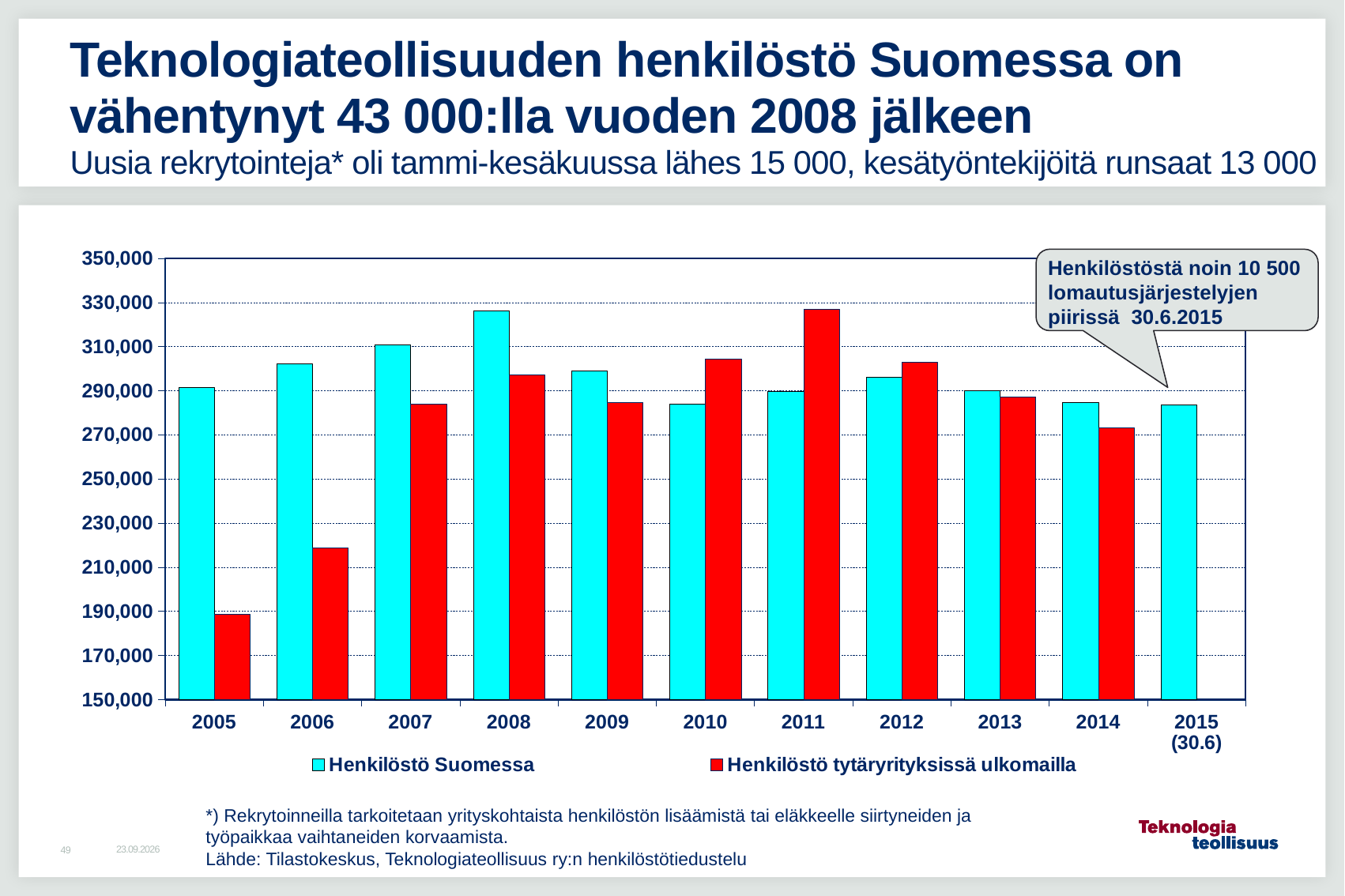
Is the value for Henkilöstö Suomessa in 2008 greater or less than 310,000? greater In which year is the value for Henkilöstö tytäryrityksissä ulkomailla highest? 2011 In 2011, which series has the larger value: Henkilöstö Suomessa or Henkilöstö tytäryrityksissä ulkomailla? Henkilöstö tytäryrityksissä ulkomailla What kind of chart is shown on the slide? bar chart In which year is the value for Henkilöstö Suomessa highest? 2008 Is the value for Henkilöstö Suomessa in 2015 (30.6) greater or less than 290,000? less How many year categories are shown on the x axis? 11 In which year is the value for Henkilöstö tytäryrityksissä ulkomailla lowest? 2005 In 2005, which series has the larger value: Henkilöstö Suomessa or Henkilöstö tytäryrityksissä ulkomailla? Henkilöstö Suomessa Is the value for Henkilöstö tytäryrityksissä ulkomailla in 2005 greater or less than 210,000? less Does the value for Henkilöstö tytäryrityksissä ulkomailla rise or fall from 2005 to 2008? rise How many series does the legend list? 2